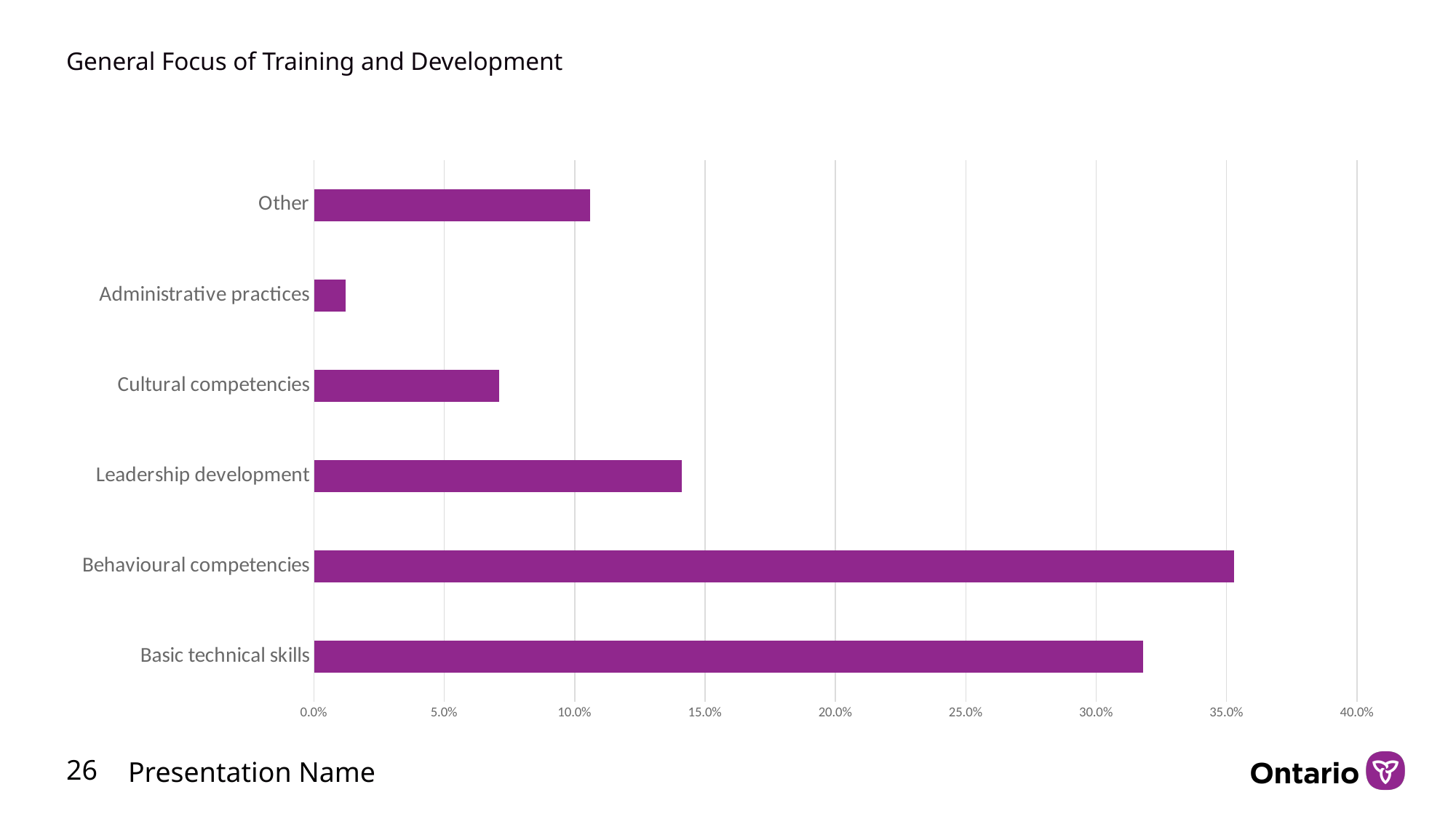
Is the value for Administrative practices greater or less than 5.0%? less Which is larger, the value for Other or the value for Cultural competencies? Other What is the title of the chart on the slide? General Focus of Training and Development What kind of chart is shown on the slide? bar chart Is the value for Basic technical skills greater or less than 30.0%? greater How many categories are plotted in the chart? 6 Is the value for Leadership development greater or less than 15.0%? less Which category has the highest value? Behavioural competencies Which category has the lowest value? Administrative practices Which is larger, the value for Basic technical skills or the value for Leadership development? Basic technical skills